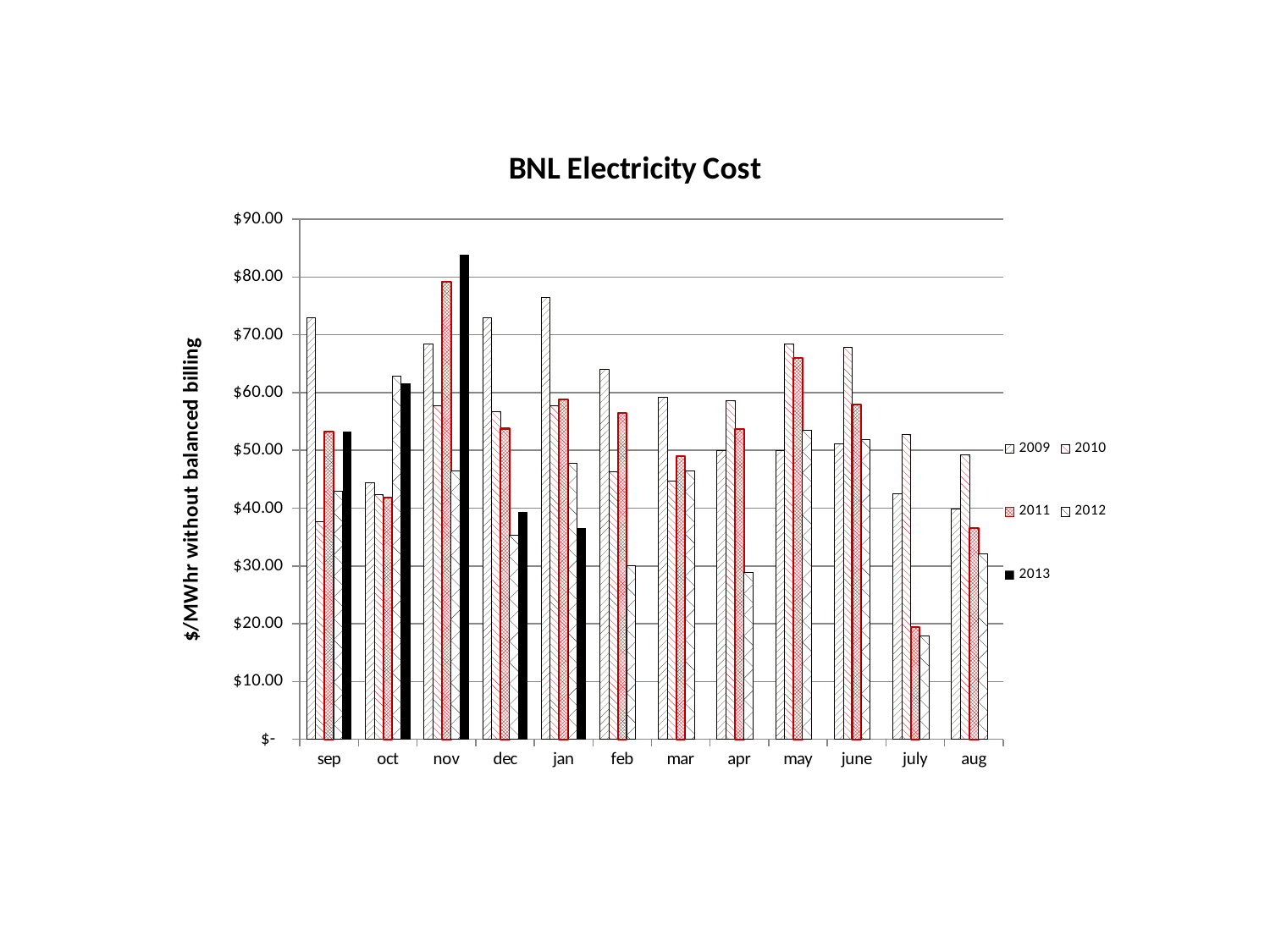
What is the title of the chart? BNL Electricity Cost Does the 2011 series rise or fall from may to july? fall In which month does the 2013 series reach its highest value? nov How many series does the legend list? 5 Is the 2013 value for nov greater or less than $80.00? greater Is the 2012 value for july greater or less than $20.00? less Is the 2009 value for jan greater or less than $70.00? greater What kind of chart is shown on the slide? bar chart For sep, which series has the larger value, 2009 or 2010? 2009 Which month contains the tallest bar in the chart? nov For nov, which series has the larger value, 2011 or 2013? 2013 How many months are shown on the x axis? 12